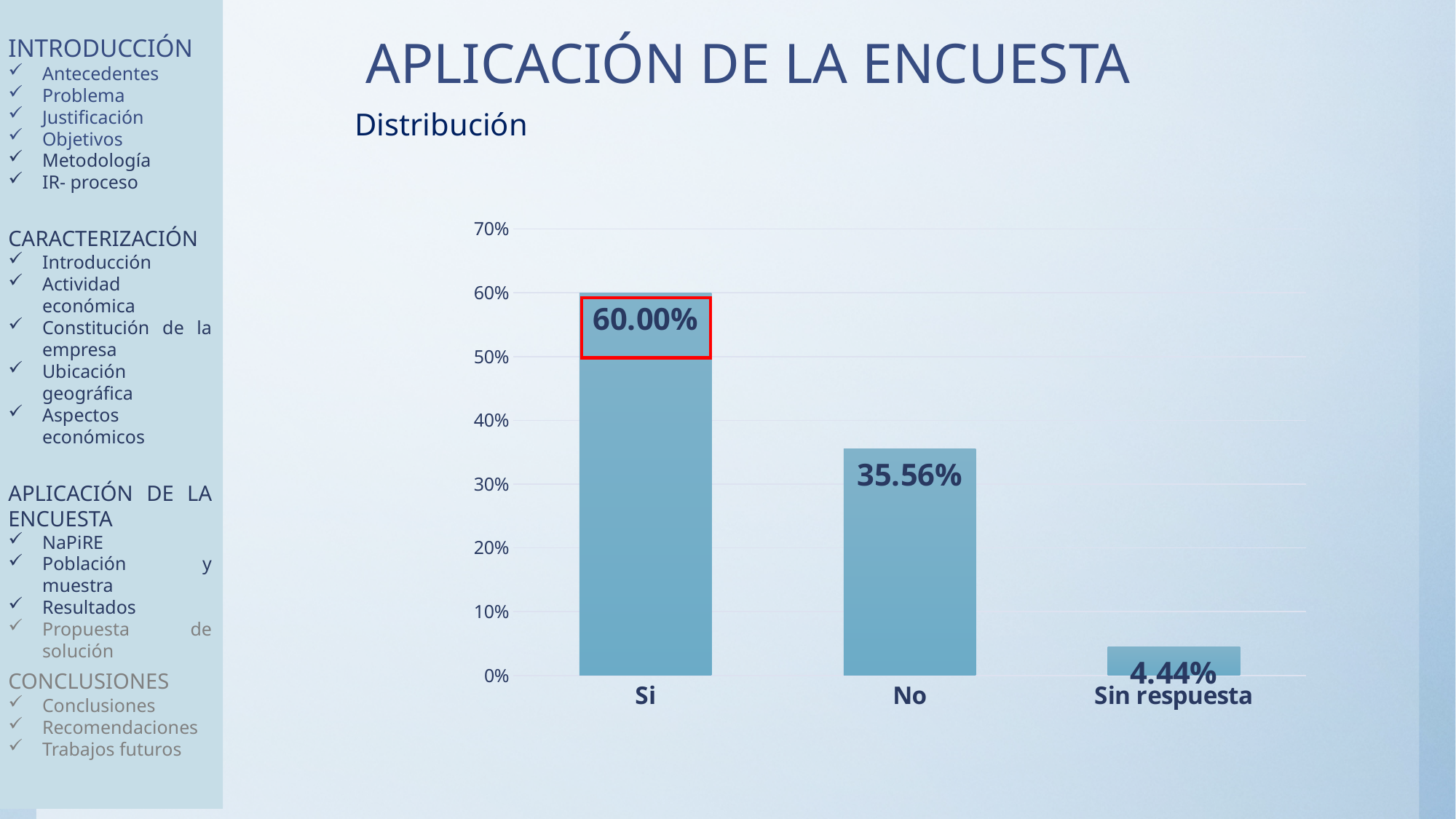
Is the value for "No" greater or less than 40%? less What kind of chart is shown on the slide? bar chart Which category has the highest value? Si What is the difference between the values for "No" and "Sin respuesta"? 31.12% Which is larger, the value for "No" or the value for "Sin respuesta"? No What is the value for the "Sin respuesta" category? 4.44% Which category has the lowest value? Sin respuesta What is the difference between the values for "Si" and "No"? 24.44% Do the values rise or fall from left to right along the x axis? fall What is the value for the "Si" category? 60.00% What is the value for the "No" category? 35.56% How many categories are shown on the x axis? 3